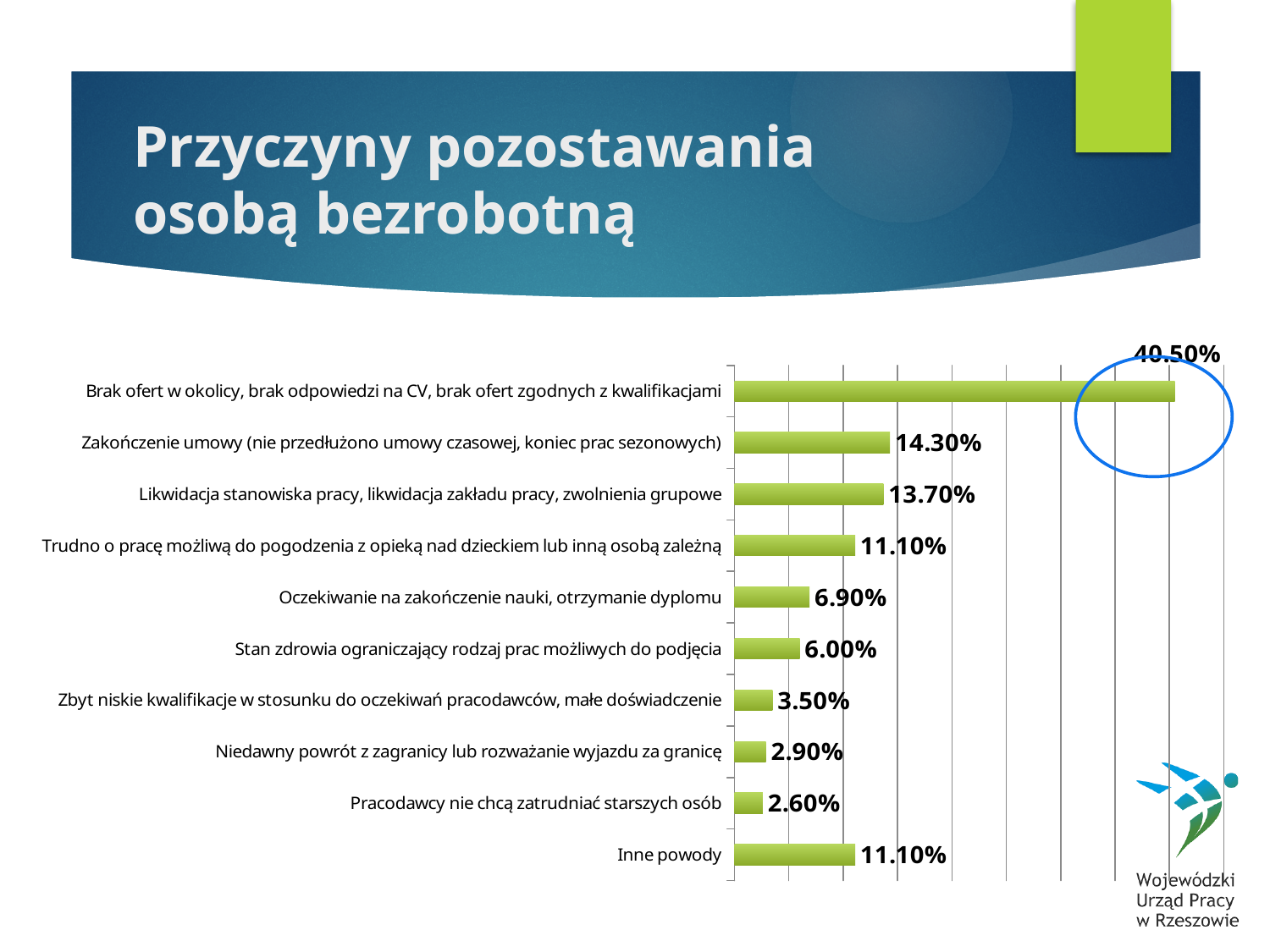
Which category has the lowest value? Pracodawcy nie chcą zatrudniać starszych osób What is the value for "Oczekiwanie na zakończenie nauki, otrzymanie dyplomu"? 6.90% What is the title of the slide? Przyczyny pozostawania osobą bezrobotną What is the difference between the values for "Zakończenie umowy (nie przedłużono umowy czasowej, koniec prac sezonowych)" and "Likwidacja stanowiska pracy, likwidacja zakładu pracy, zwolnienia grupowe"? 0.60% What is the value for "Inne powody"? 11.10% How many categories are shown in the chart? 10 What is the value for "Zakończenie umowy (nie przedłużono umowy czasowej, koniec prac sezonowych)"? 14.30% Which is larger: the value for "Niedawny powrót z zagranicy lub rozważanie wyjazdu za granicę" or for "Zbyt niskie kwalifikacje w stosunku do oczekiwań pracodawców, małe doświadczenie"? Zbyt niskie kwalifikacje w stosunku do oczekiwań pracodawców, małe doświadczenie What kind of chart is shown on the slide? Bar chart Which category has the highest value? Brak ofert w okolicy, brak odpowiedzi na CV, brak ofert zgodnych z kwalifikacjami What is the value for "Pracodawcy nie chcą zatrudniać starszych osób"? 2.60% What is the difference between the values for "Stan zdrowia ograniczający rodzaj prac możliwych do podjęcia" and "Zbyt niskie kwalifikacje w stosunku do oczekiwań pracodawców, małe doświadczenie"? 2.50%